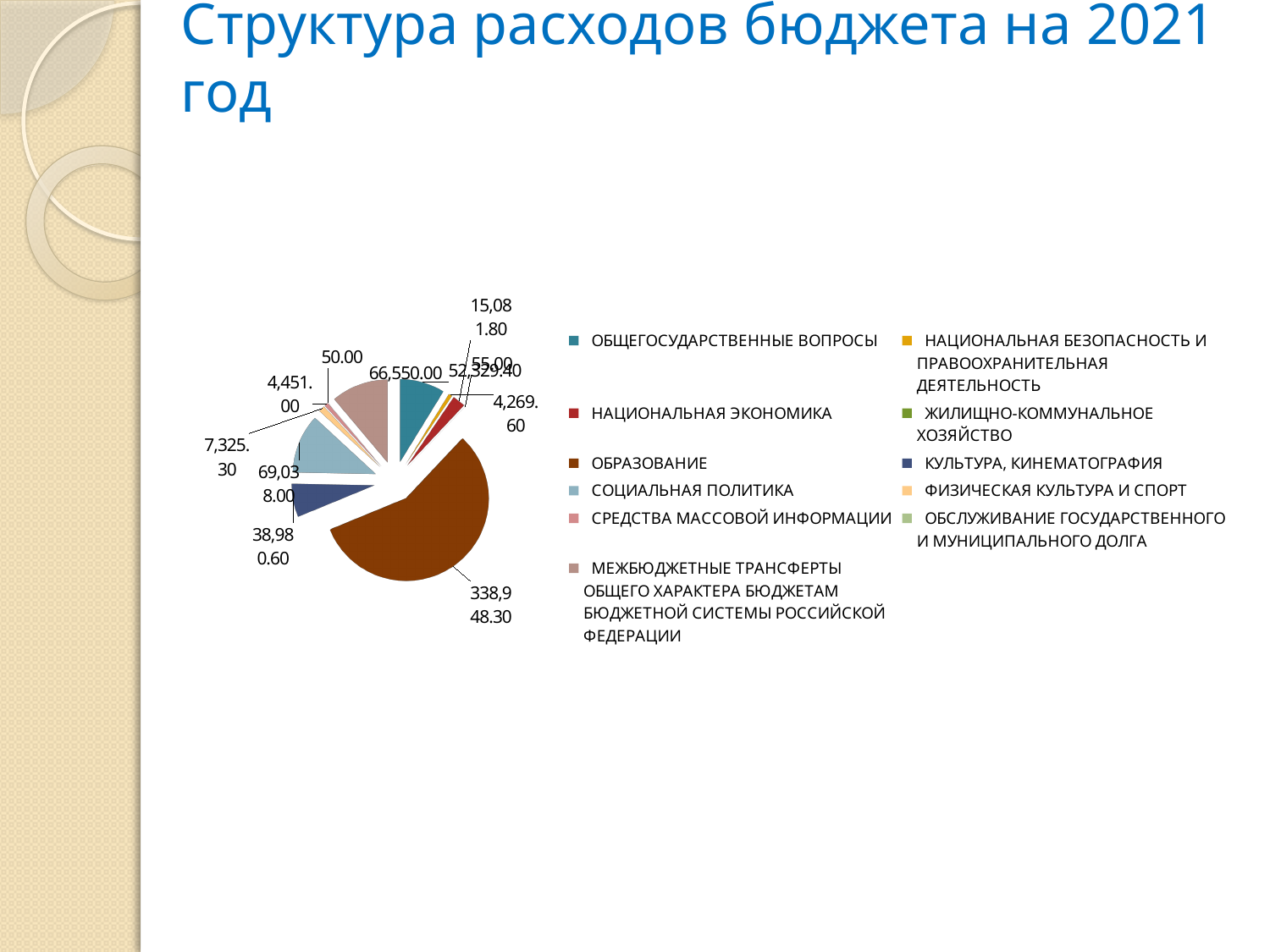
Which category has the largest slice of the pie? ОБРАЗОВАНИЕ How many categories are listed in the chart's legend? 11 What is the title of the chart on the slide? Структура расходов бюджета на 2021 год What is the difference between the values for ОБЩЕГОСУДАРСТВЕННЫЕ ВОПРОСЫ and НАЦИОНАЛЬНАЯ ЭКОНОМИКА? 37,247.60 What is the value shown for СОЦИАЛЬНАЯ ПОЛИТИКА? 69,038.00 What is the value shown for ОБЩЕГОСУДАРСТВЕННЫЕ ВОПРОСЫ? 52,329.40 What type of chart is shown on the slide? pie chart What is the difference between the values for ОБРАЗОВАНИЕ and СОЦИАЛЬНАЯ ПОЛИТИКА? 269,910.30 What is the value shown for КУЛЬТУРА, КИНЕМАТОГРАФИЯ? 38,980.60 What is the value shown for ОБРАЗОВАНИЕ? 338,948.30 What is the value shown for НАЦИОНАЛЬНАЯ ЭКОНОМИКА? 15,081.80 Which is larger, the value for СОЦИАЛЬНАЯ ПОЛИТИКА or the value for ОБЩЕГОСУДАРСТВЕННЫЕ ВОПРОСЫ? СОЦИАЛЬНАЯ ПОЛИТИКА